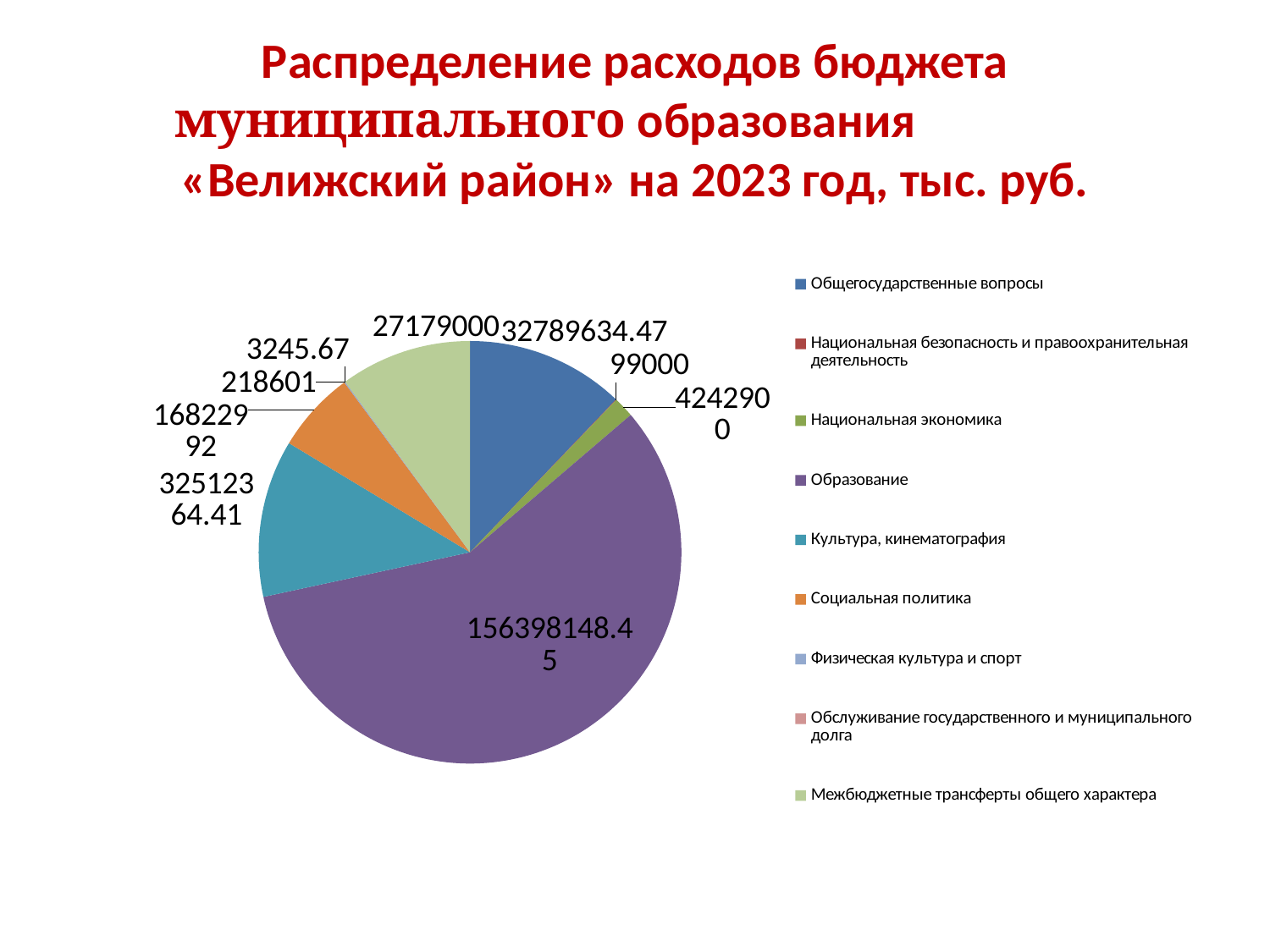
What is the value for Межбюджетные трансферты общего характера? 27179000 What colour is the slice for Культура, кинематография? Teal Which is larger: Межбюджетные трансферты общего характера or Социальная политика? Межбюджетные трансферты общего характера What is the value for Национальная безопасность и правоохранительная деятельность? 99000 How many categories does the legend of the pie chart list? 9 What is the difference between the values for Межбюджетные трансферты общего характера and Социальная политика? 10356008 Which category has the largest slice of the pie? Образование Which category has the smallest value? Обслуживание государственного и муниципального долга What is the value for Образование? 156398148.45 What type of chart is shown on the slide? Pie chart What is the value for Социальная политика? 16822992 What is the value for Общегосударственные вопросы? 32789634.47